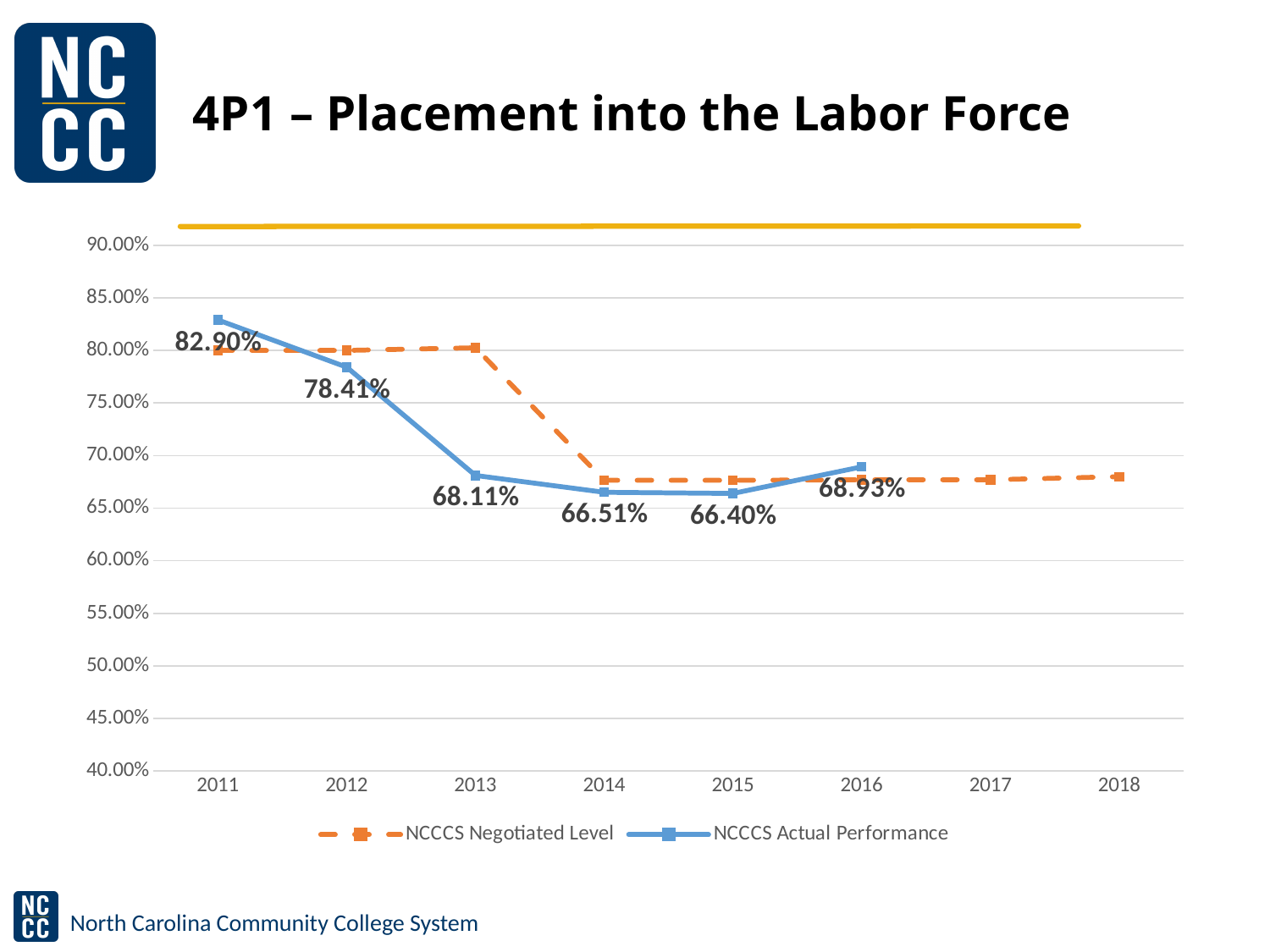
By how many percentage points did NCCCS Actual Performance fall from 2011 to 2012? 4.49 percentage points What is the difference between NCCCS Actual Performance in 2013 and 2014? 1.60 percentage points In which year is NCCCS Actual Performance lowest? 2015 How many years are shown on the x axis? 8 Is the NCCCS Negotiated Level for 2018 greater or less than 70.00%? less How many series does the legend list? 2 Which year has the higher NCCCS Actual Performance, 2015 or 2016? 2016 In which year is NCCCS Actual Performance highest? 2011 Is the NCCCS Negotiated Level for 2012 greater or less than 75.00%? greater What is the NCCCS Actual Performance value for 2016? 68.93% What kind of chart is shown on the slide? Line chart What is the NCCCS Actual Performance value for 2011? 82.90%